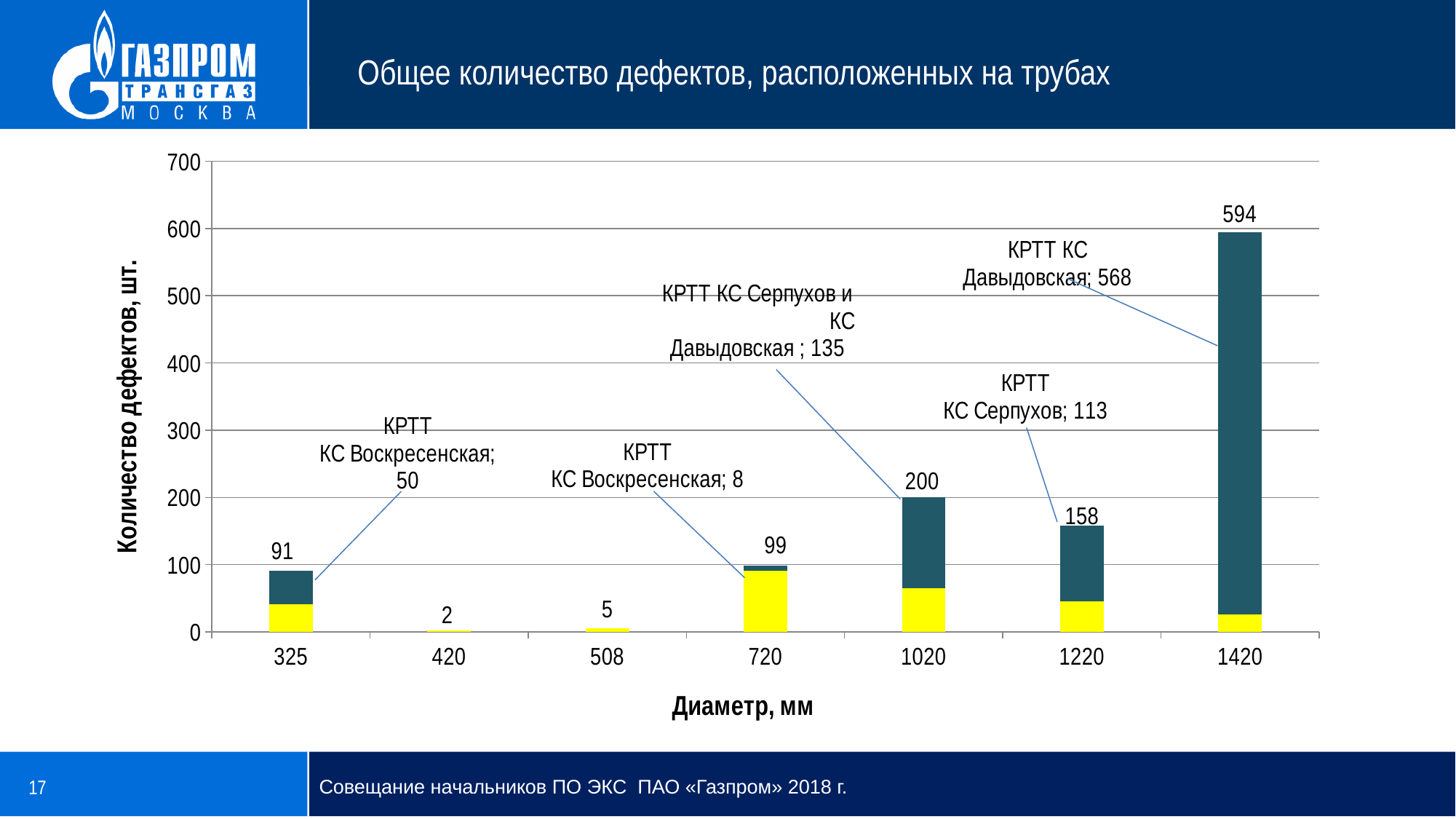
What is the total number of defects for pipes with diameter 720 mm? 99 What is the title of the vertical axis? Количество дефектов, шт. Which pipe diameter has the lowest total number of defects? 420 What is the difference between the total defects for diameter 1420 mm and diameter 1020 mm? 394 How many defects are attributed to КРТТ КС Серпухов for diameter 1220 mm according to the annotation? 113 How many pipe diameter categories are shown on the x axis? 7 What is the total number of defects for pipes with diameter 508 mm? 5 How many defects are attributed to КРТТ КС Давыдовская for diameter 1420 mm according to the annotation? 568 What is the total number of defects for pipes with diameter 1420 mm? 594 Which has more total defects: diameter 1020 mm or diameter 1220 mm? 1020 Which pipe diameter has the highest total number of defects? 1420 What kind of chart is shown on the slide? Stacked bar chart